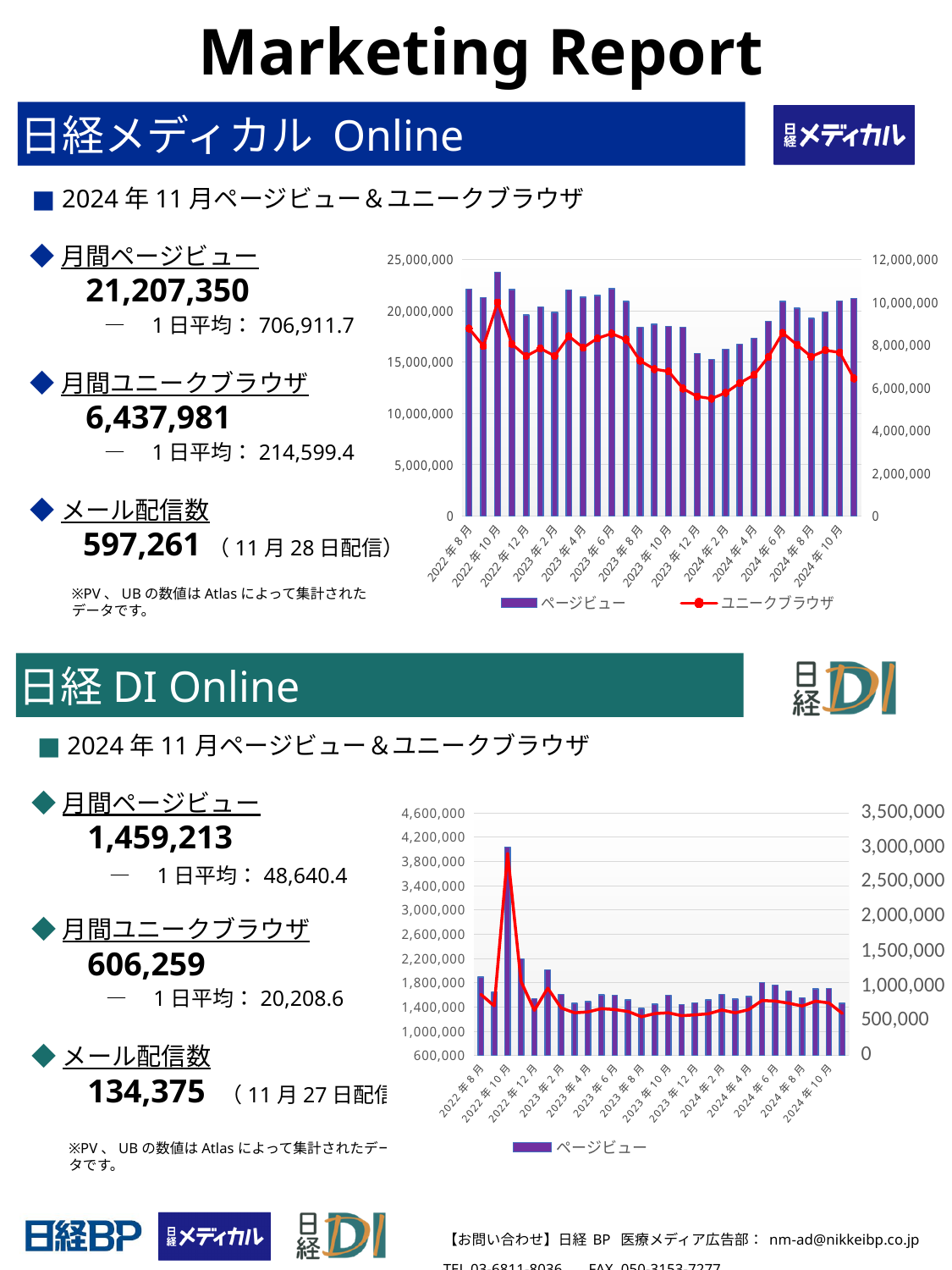
In the top chart (日経メディカル Online), which month has the highest page view bar? 2022年10月 In the top chart (日経メディカル Online), is the page view bar for 2023年12月 greater or less than 20,000,000? less What kind of chart is the top chart (日経メディカル Online)? bar chart with a line In the bottom chart (日経 DI Online), which month has the highest page view bar? 2022年10月 In the top chart (日経メディカル Online), does the unique browser line rise or fall from 2023年6月 to 2023年12月? fall In the top chart (日経メディカル Online), is the page view bar for 2022年10月 greater or less than 20,000,000? greater In the top chart (日経メディカル Online), what is the maximum value shown on the right-hand axis? 12,000,000 In the bottom chart (日経 DI Online), how many month labels are shown on the x axis? 14 In the bottom chart (日経 DI Online), do the page view bars rise or fall from 2022年10月 to 2022年12月? fall In the bottom chart (日経 DI Online), which page view bar is taller, 2022年10月 or 2023年4月? 2022年10月 In the bottom chart (日経 DI Online), is the page view bar for 2022年10月 greater or less than 3,400,000? greater In the top chart (日経メディカル Online), how many series does the legend list? 2